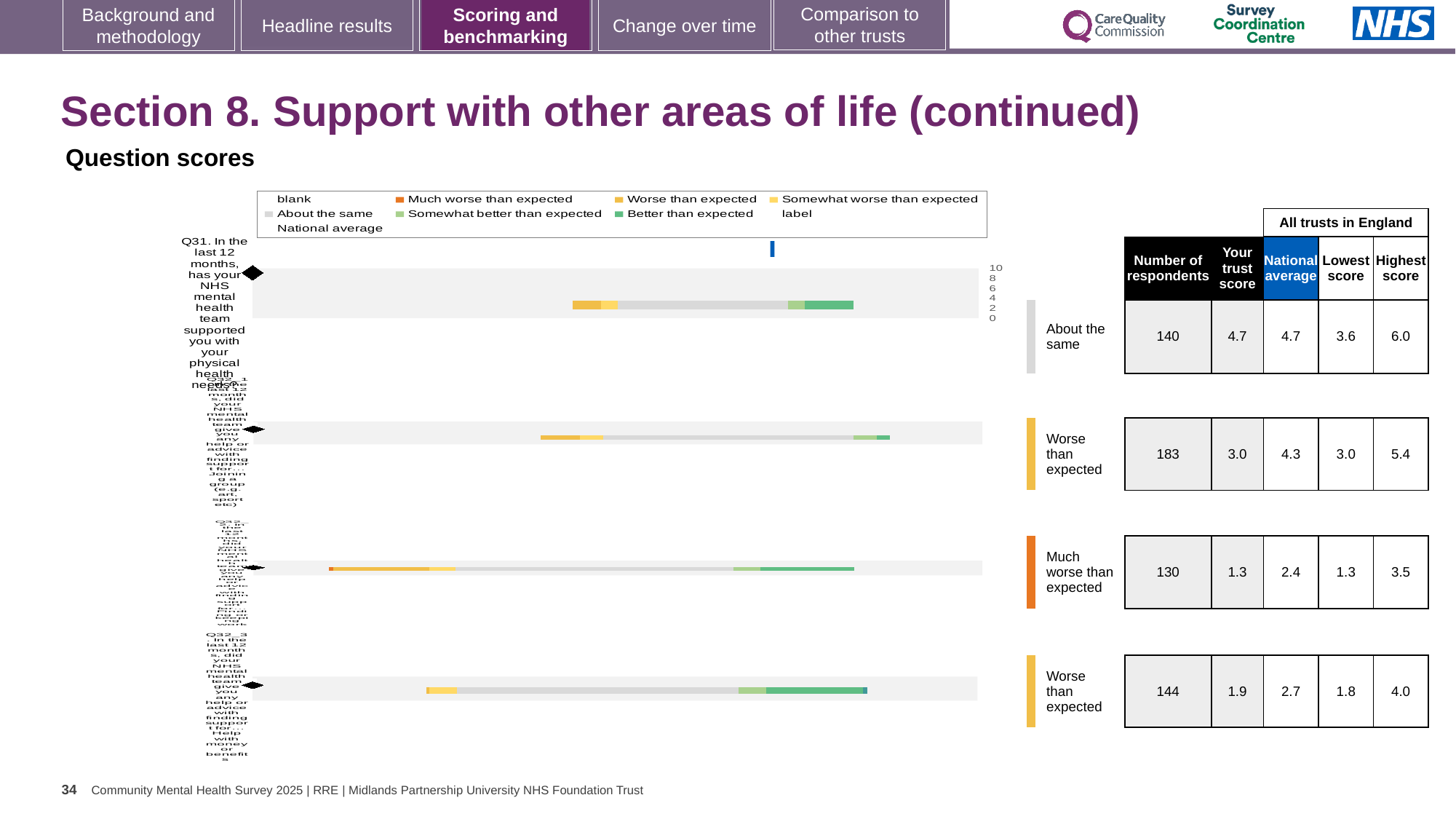
Which question has the highest trust score? Q31 What is the trust score for Q31 (support with physical health needs)? 4.7 How many entries does the legend of the question scores chart list? 9 What is the highest score among all trusts in England for Q32_3 (help with money or benefits)? 4.0 How many respondents answered Q31 (support with physical health needs)? 140 Which benchmark category is shown for Q31 (support with physical health needs)? About the same Which row has the lowest trust score: the one rated 'About the same', 'Much worse than expected', or either 'Worse than expected' row? Much worse than expected How many questions (bars) are plotted in the question scores chart? 4 What is the national average for Q32_1 (help finding support for joining a group)? 4.3 What type of chart is used to show the question scores on this slide? bar chart What is the difference between the national average and the trust score for Q32_1 (help finding support for joining a group)? 1.3 For Q32_3 (help with money or benefits), which is larger: the trust score or the national average? national average